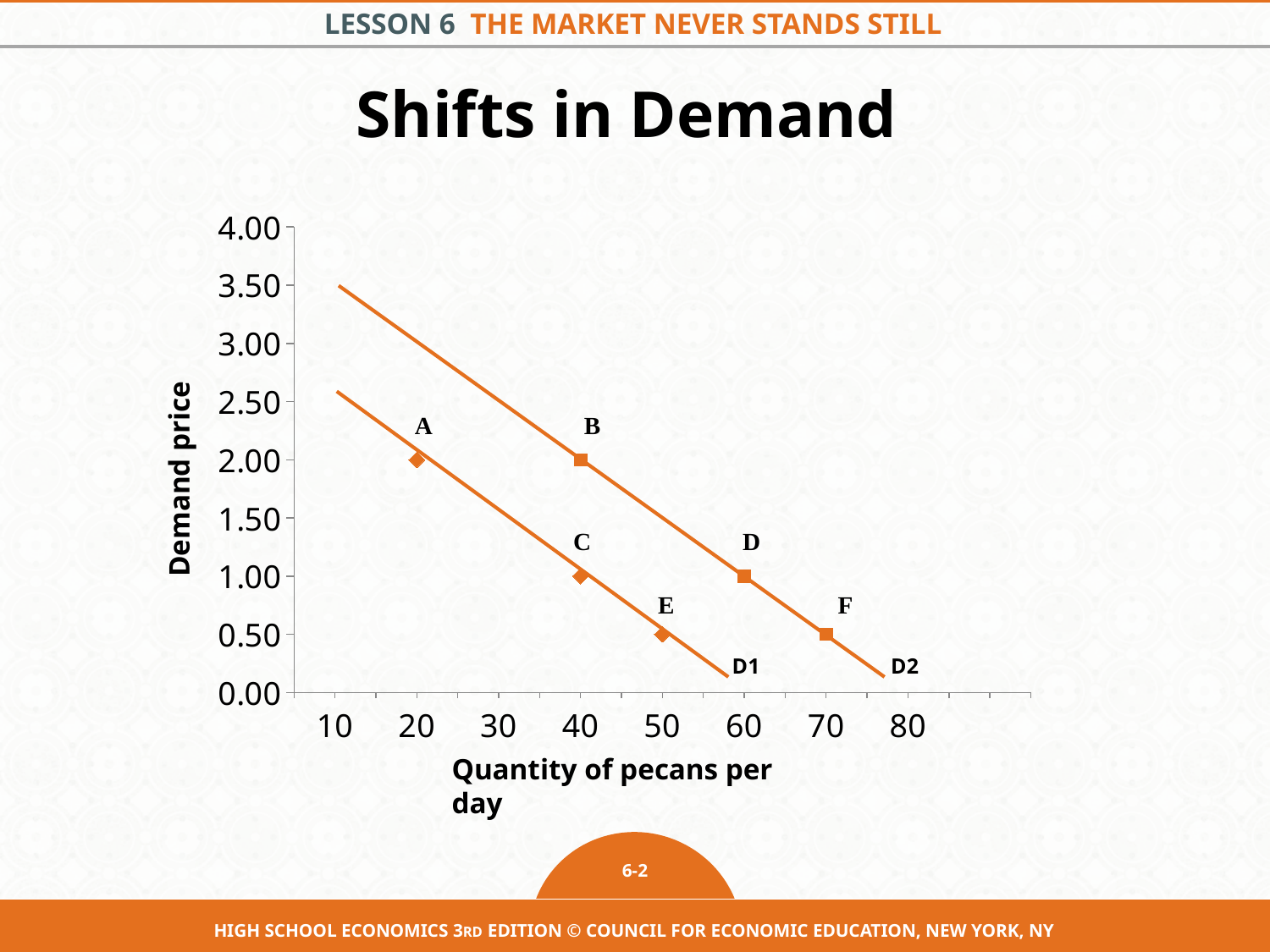
How many labeled points are plotted on the chart? 6 What kind of chart is shown on the slide? scatter chart What is the title of the x axis? Quantity of pecans per day As the quantity of pecans per day increases along each demand curve, does the demand price rise or fall? fall What is the demand price at point E? 0.50 What is the quantity of pecans per day at point F? 70 What is the quantity of pecans per day at point B? 40 Which labeled point has the highest quantity of pecans per day? F What is the demand price at point A? 2.00 Which labeled point has the lowest quantity of pecans per day? A What is the difference in quantity between point D and point C? 20 Which point has a higher demand price, A or E? A